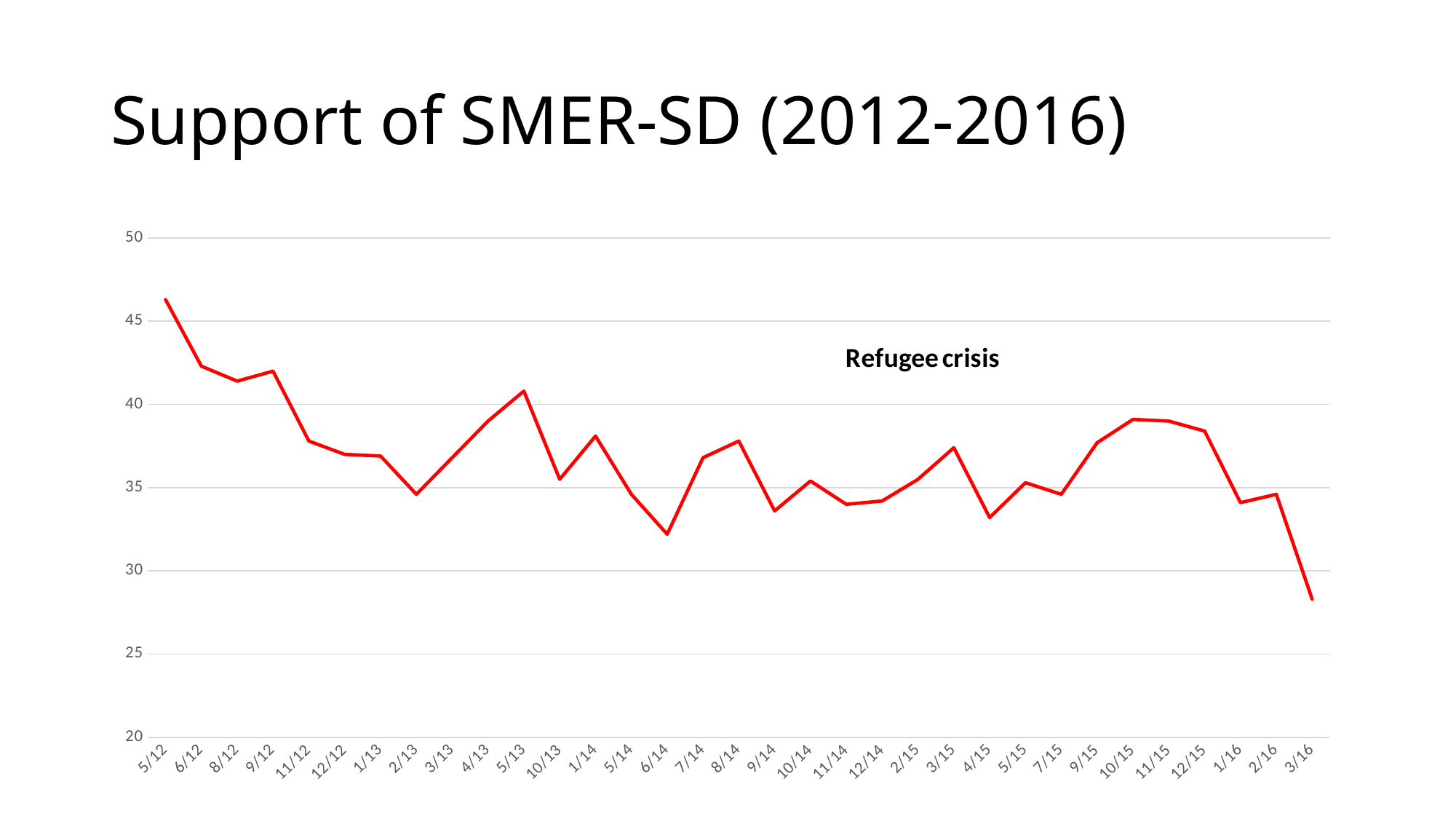
At which date is the support value lowest? 3/16 Is the value for 5/12 greater or less than 45? greater How many data points are plotted along the x axis? 33 What text annotation is placed above the line in the chart? Refugee crisis Is the value for 8/14 greater or less than 35? greater What kind of chart is shown on the slide? line chart Is the value for 6/14 greater or less than 35? less At which date is the support value highest? 5/12 Which has the higher value, 5/13 or 6/14? 5/13 Overall, do the values rise or fall from 5/12 to 3/16? fall What is the title of the chart? Support of SMER-SD (2012-2016)